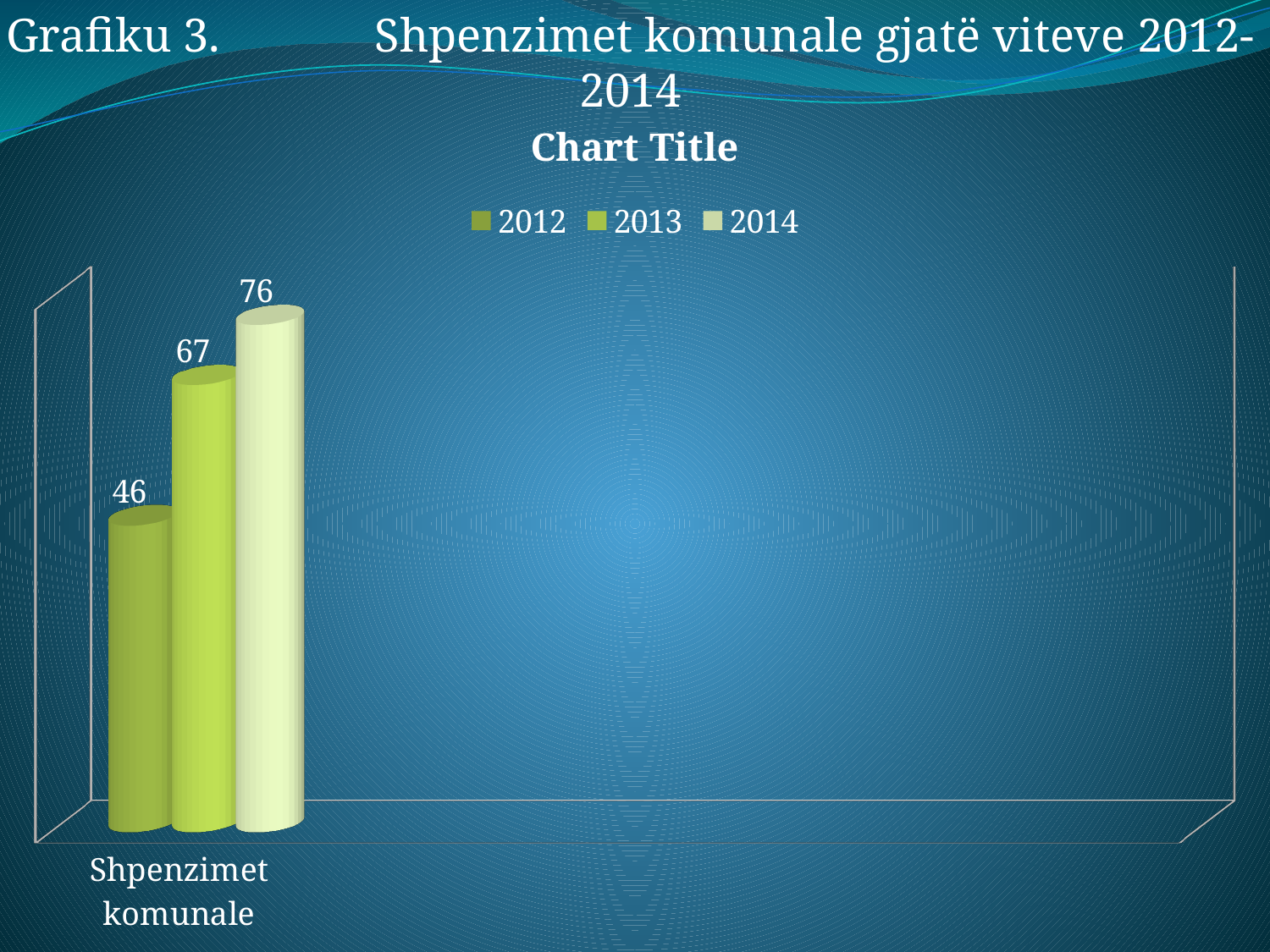
Which year has the lowest value for Shpenzimet komunale? 2012 What is the difference between the 2013 and 2012 values for Shpenzimet komunale? 21 What kind of chart is shown on the slide? bar chart What is the difference between the 2014 and 2012 values for Shpenzimet komunale? 30 Which is larger, the value for 2013 or the value for 2014? 2014 What is the value for 2014 for Shpenzimet komunale? 76 What is the value for 2013 for Shpenzimet komunale? 67 How many categories are shown on the x axis? 1 What is the value for 2012 for Shpenzimet komunale? 46 Do the values rise or fall from 2012 to 2014? rise Which year has the highest value for Shpenzimet komunale? 2014 How many series does the legend list? 3